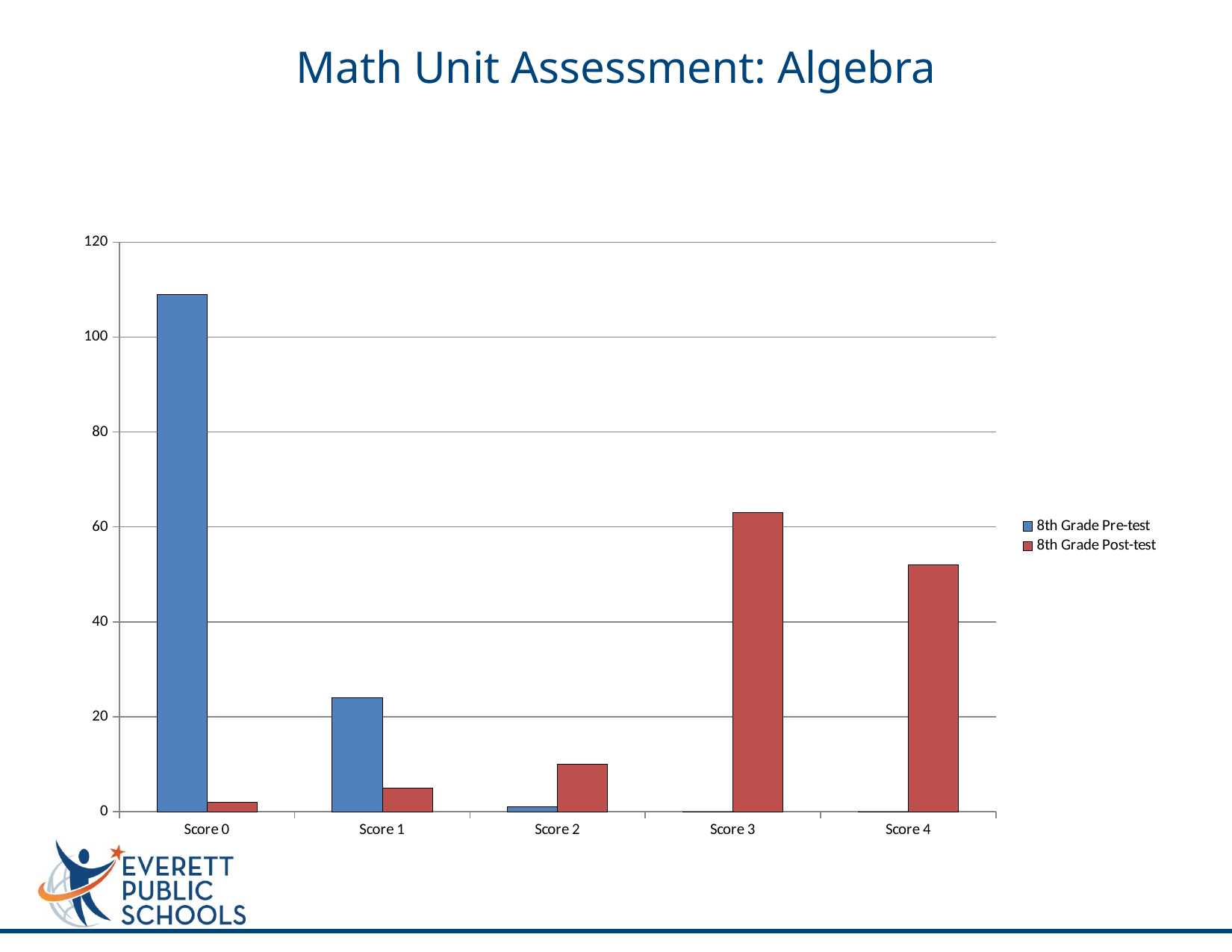
How many series does the legend list? 2 Which score category has the highest 8th Grade Pre-test value? Score 0 Is the 8th Grade Post-test value for Score 4 greater or less than 60? less Is the 8th Grade Pre-test value for Score 1 greater or less than 20? greater Which score category has the highest 8th Grade Post-test value? Score 3 How many score categories are shown on the x axis? 5 For Score 3, which series has the larger value, 8th Grade Pre-test or 8th Grade Post-test? 8th Grade Post-test Is the 8th Grade Pre-test value for Score 0 greater or less than 100? greater Which score category has the lowest 8th Grade Post-test value? Score 0 Which series is shown in red? 8th Grade Post-test What kind of chart is shown on the slide? bar chart